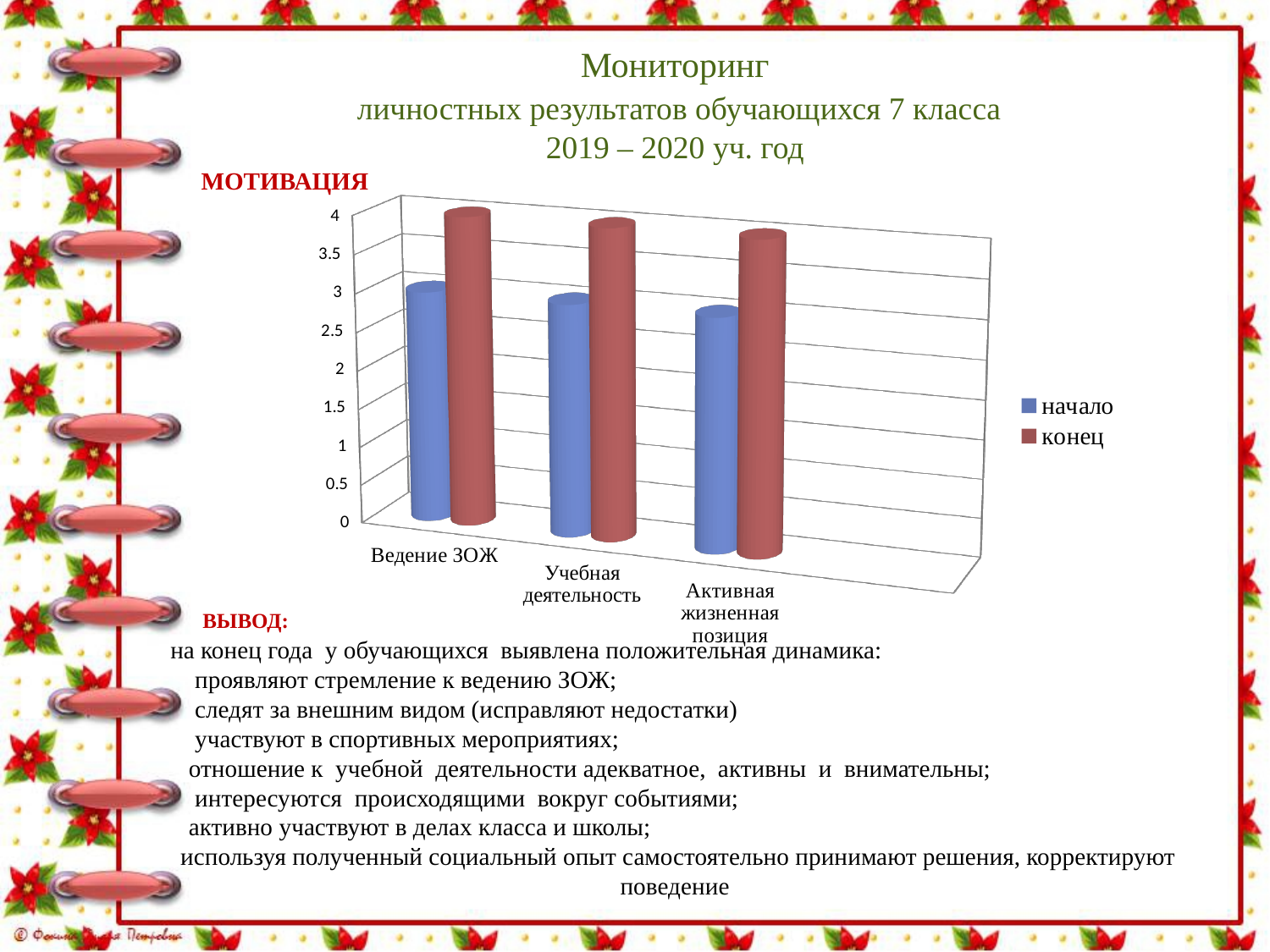
Is the конец value for Ведение ЗОЖ greater or less than 3? greater What kind of chart is shown on the slide? bar chart How many series does the chart legend list? 2 Is the начало value for Ведение ЗОЖ greater or less than 2? greater For Активная жизненная позиция, which series has the larger value, начало or конец? конец What are the two series named in the chart legend? начало, конец How many categories are shown on the x axis of the chart? 3 What heading is written above the chart? МОТИВАЦИЯ For Ведение ЗОЖ, which series has the larger value, начало or конец? конец